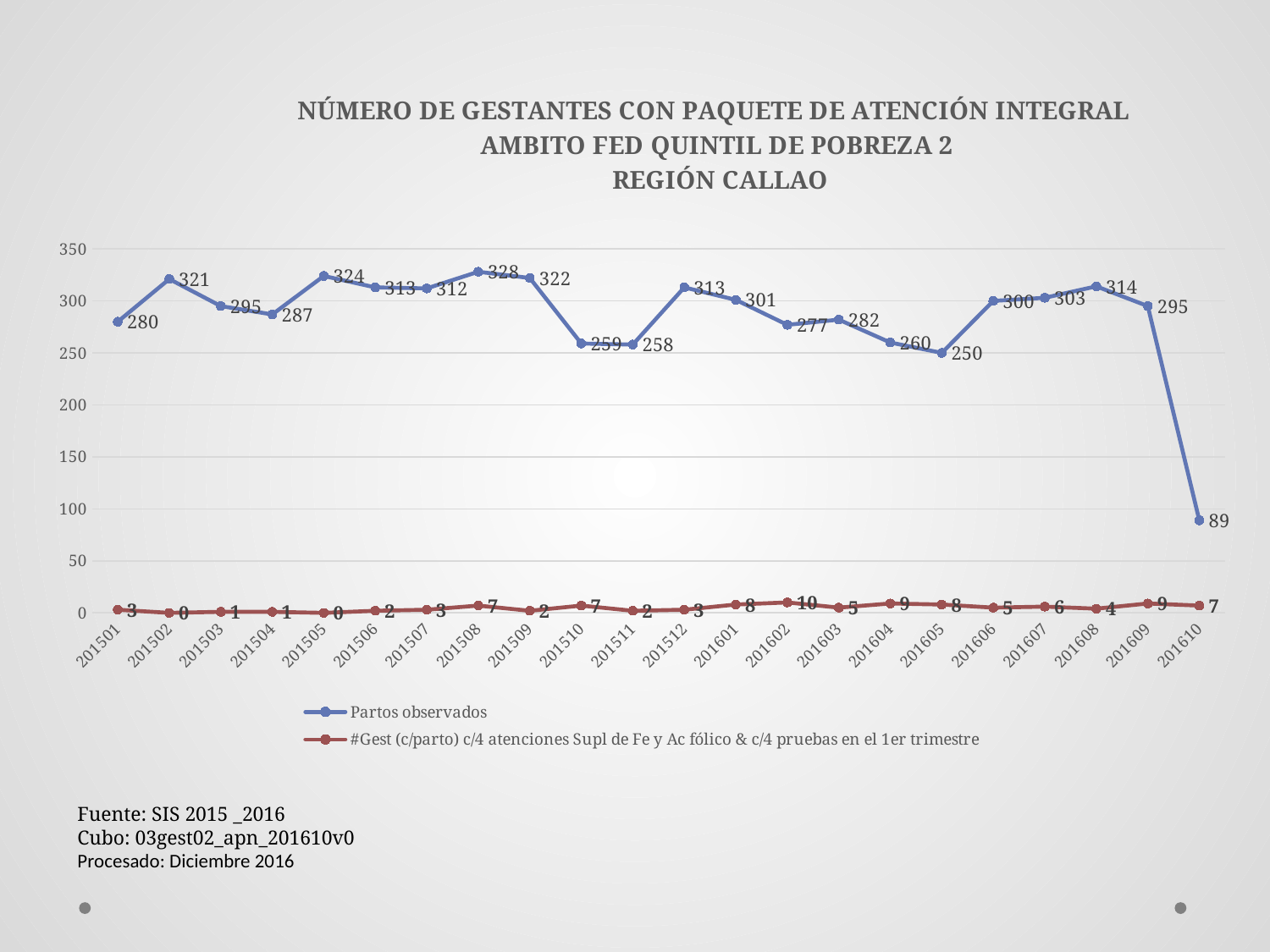
What is the value of Partos observados for 201508? 328 How many months (data points) are plotted along the x axis? 22 What is the value of the #Gest (c/parto) series for 201602? 10 Is the value of Partos observados for 201605 greater or less than 300? less How many series does the legend list? 2 In which month does Partos observados reach its lowest value? 201610 What is the difference between Partos observados in 201609 and 201610? 206 What type of chart is shown on the slide? Line chart What is the region named in the chart title? REGIÓN CALLAO In which month does Partos observados reach its highest value? 201508 What is the value of Partos observados for 201610? 89 Which is larger, Partos observados in 201502 or in 201505? 201505